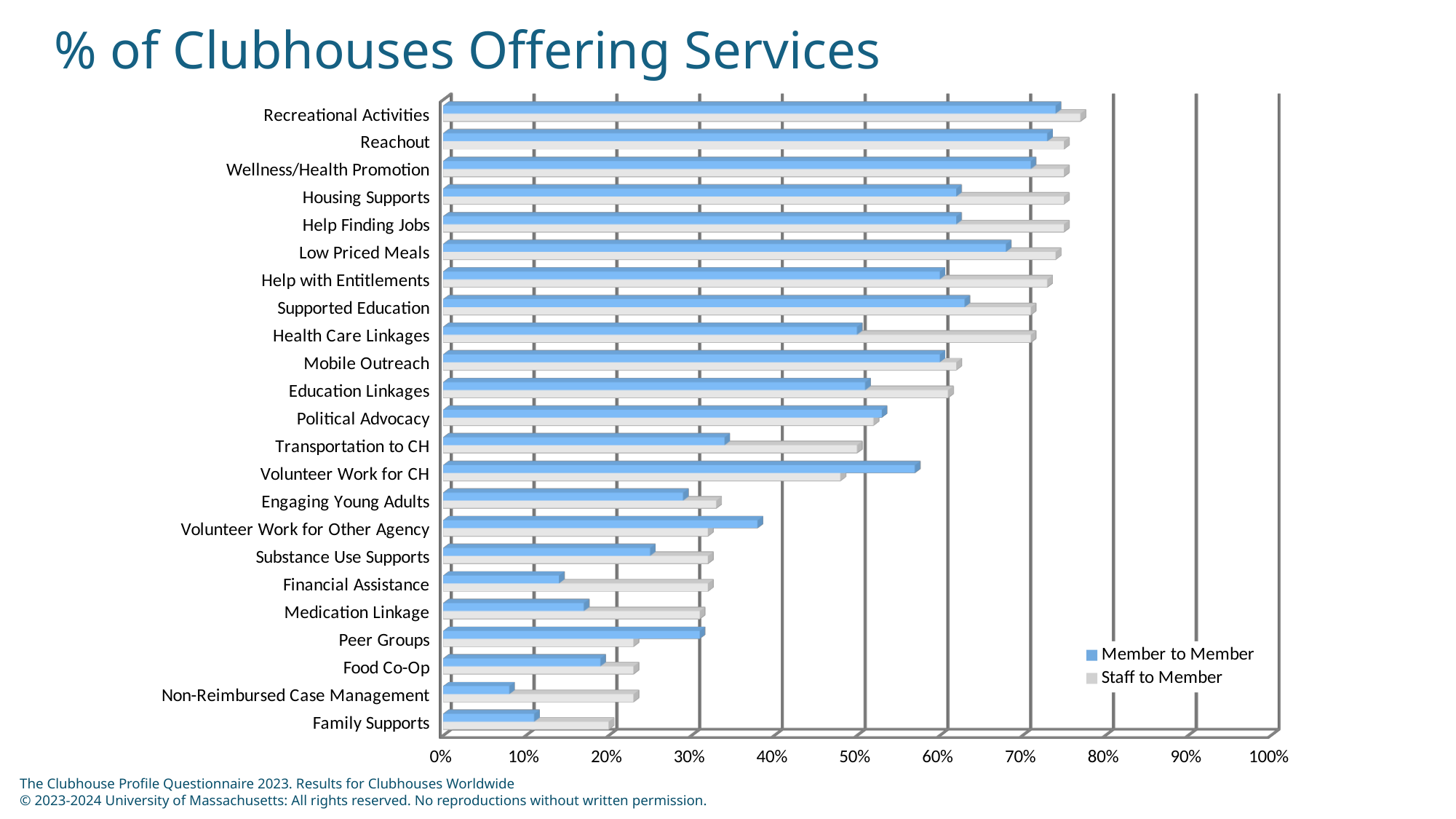
What kind of chart is shown on the slide? Bar chart Which category has the lowest Member to Member value? Non-Reimbursed Case Management Is the Staff to Member value for Health Care Linkages greater or less than 60%? greater For Volunteer Work for CH, which is larger: the Member to Member value or the Staff to Member value? Member to Member Is the Member to Member value for Recreational Activities greater or less than 70%? greater How many service categories are plotted on the chart? 23 What is the title of the chart? % of Clubhouses Offering Services Which category has the highest Staff to Member value? Recreational Activities Is the Member to Member value for Family Supports greater or less than 20%? less Which series is shown in blue? Member to Member For Housing Supports, which is larger: the Member to Member value or the Staff to Member value? Staff to Member How many series does the legend list? 2